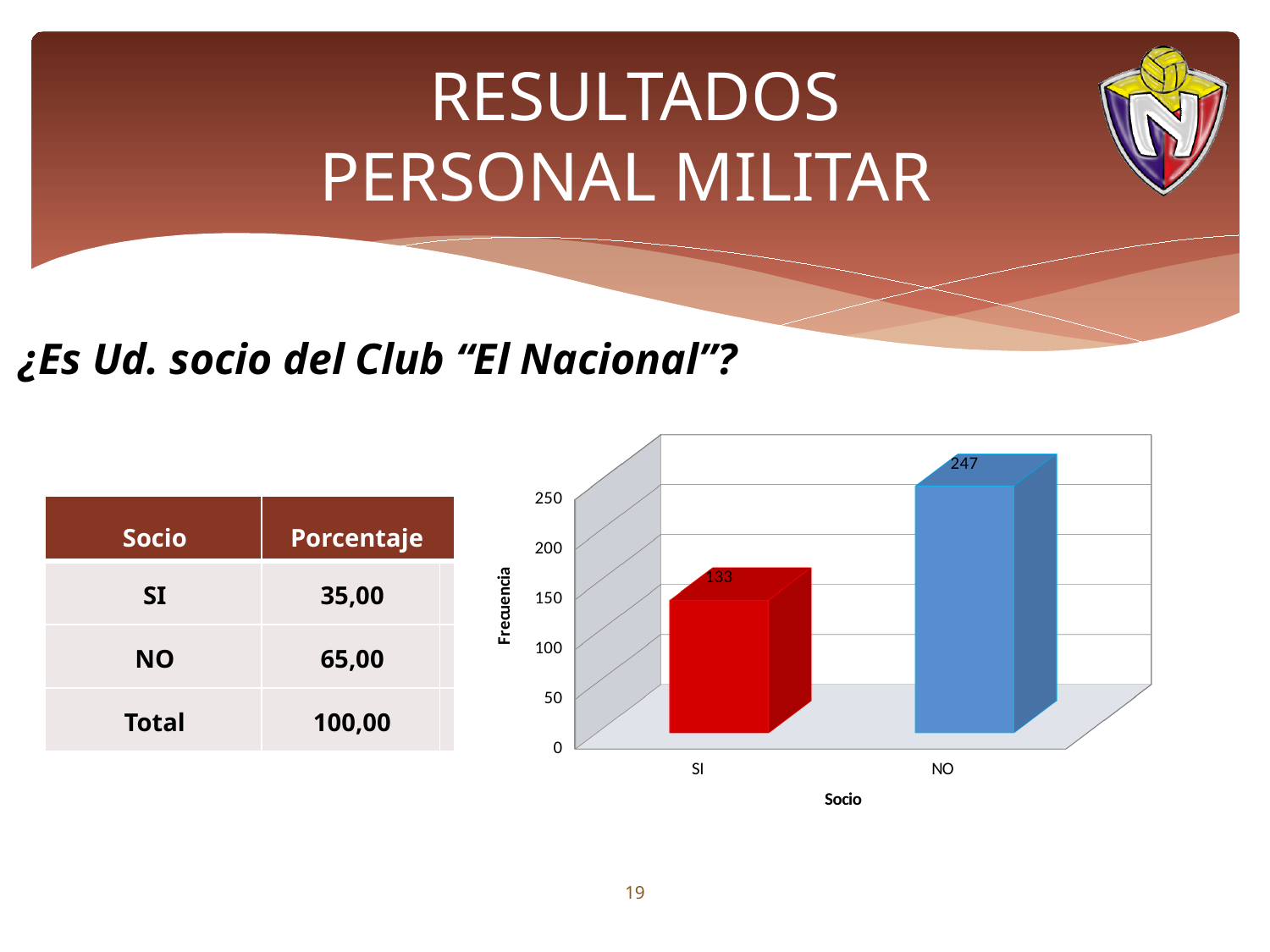
Which is larger, the frequency for SI or the frequency for NO? NO Is the frequency for NO greater or less than 200? greater What kind of chart is shown on the slide? bar chart What is the label of the vertical axis of the chart? Frecuencia Which category has the highest frequency in the chart? NO What is the difference between the frequency for NO and the frequency for SI? 114 What is the label of the horizontal axis of the chart? Socio What is the frequency value for SI in the chart? 133 What is the frequency value for NO in the chart? 247 Which category has the lowest frequency in the chart? SI How many categories are shown on the x axis of the chart? 2 Is the frequency for SI greater or less than 150? less